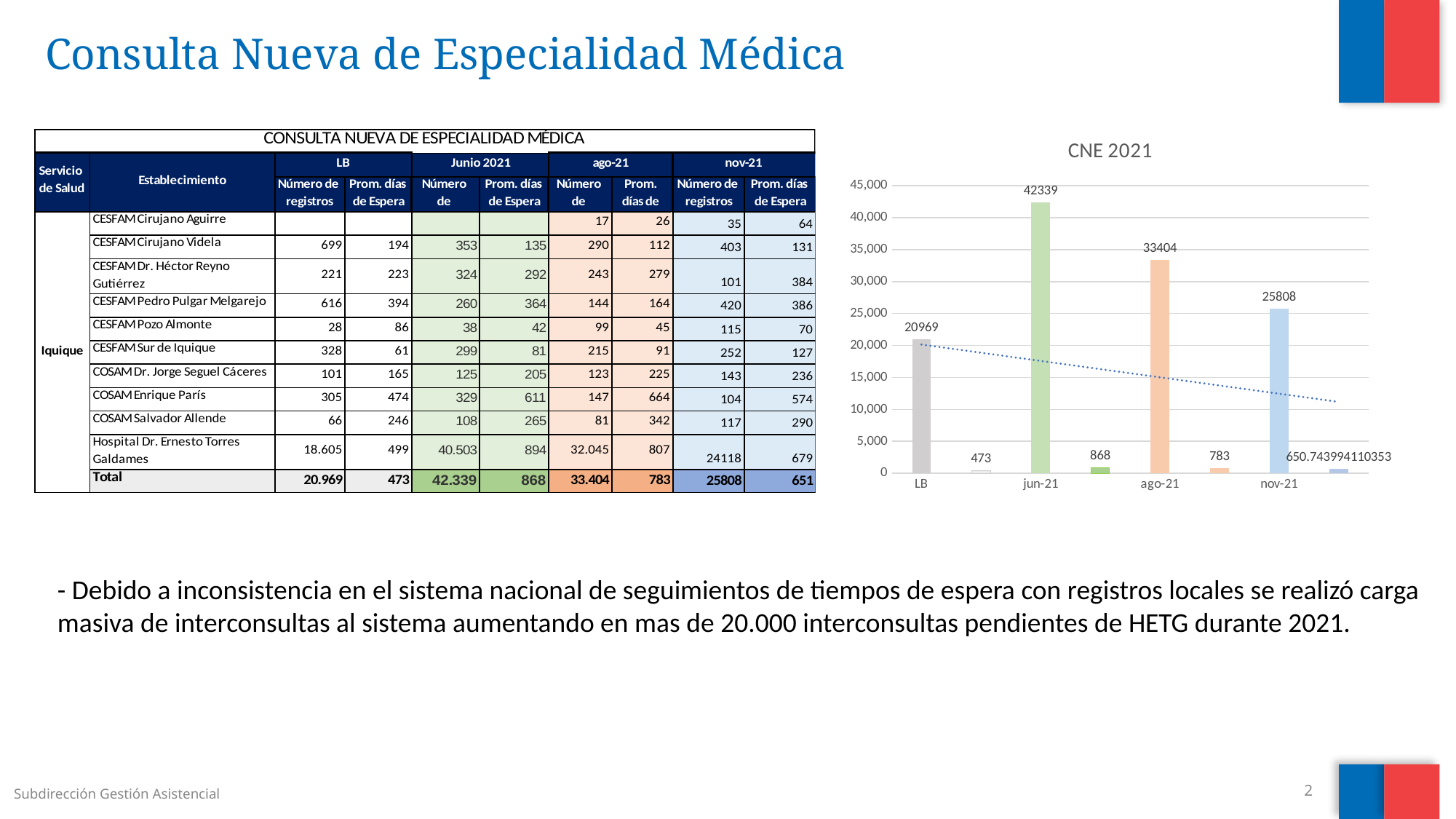
In the CNE 2021 chart, what is the value of the tall bar for LB? 20969 In the CNE 2021 chart, which category has the lowest tall bar? LB In the CNE 2021 chart, what is the difference between the tall bars for jun-21 and ago-21? 8935 In the CNE 2021 chart, is the tall bar for nov-21 greater or less than 25,000? greater In the CNE 2021 chart, what is the value of the short bar for jun-21? 868 What is the title of the chart on the right of the slide? CNE 2021 In the CNE 2021 chart, what is the value of the tall bar for jun-21? 42339 In the CNE 2021 chart, which category has the highest tall bar? jun-21 What kind of chart is the CNE 2021 chart? bar chart In the CNE 2021 chart, which is larger: the tall bar for ago-21 or the tall bar for nov-21? ago-21 In the CNE 2021 chart, what is the value of the short bar for ago-21? 783 How many categories are shown on the x axis of the CNE 2021 chart? 4